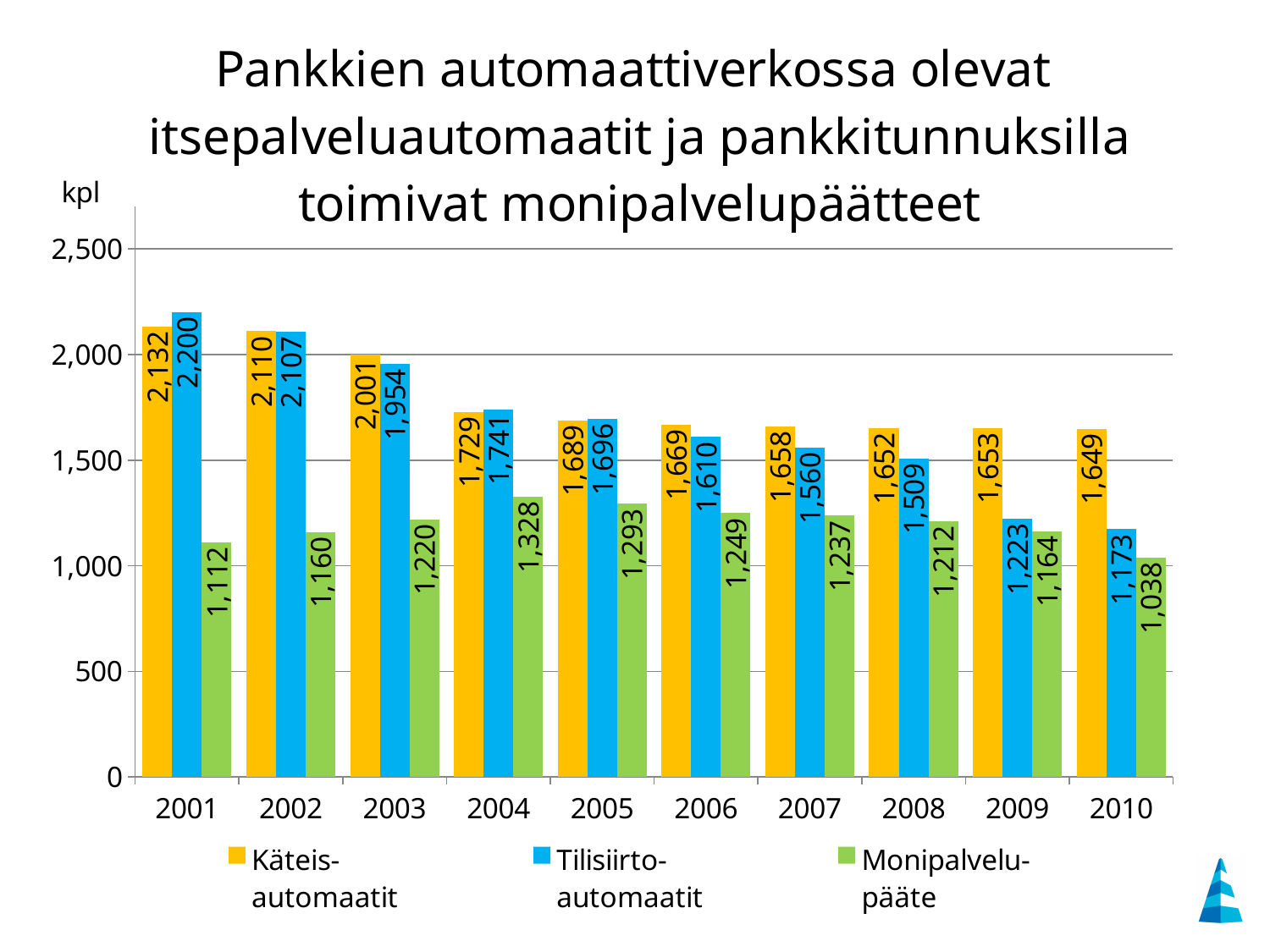
Does the Tilisiirtoautomaatit value rise or fall from 2001 to 2010? fall What kind of chart is shown on the slide? bar chart Is the value for Monipalvelupääte in 2010 greater or less than 1,000? greater In which year is the Tilisiirtoautomaatit value lowest? 2010 How many series does the legend list? 3 Which is larger in 2001, Käteisautomaatit or Tilisiirtoautomaatit? Tilisiirtoautomaatit What is the value for Monipalvelupääte in 2004? 1,328 What is the difference between the Käteisautomaatit and Tilisiirtoautomaatit values in 2009? 430 What is the value for Tilisiirtoautomaatit in 2010? 1,173 In which year is the Monipalvelupääte value highest? 2004 How many years are shown on the x axis? 10 What is the value for Käteisautomaatit in 2001? 2,132